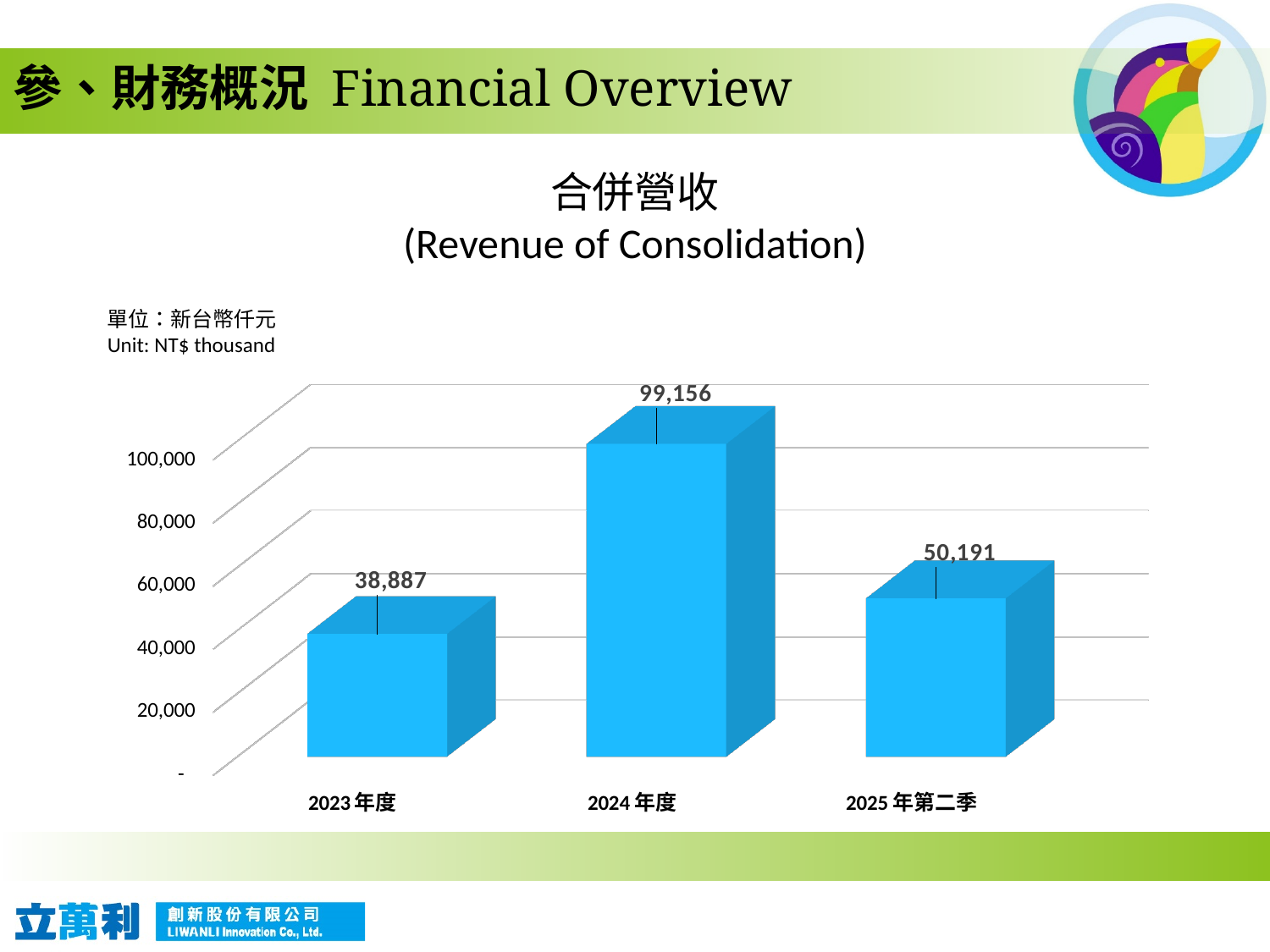
What is the consolidated revenue for 2025 年第二季? 50,191 What is the consolidated revenue for 2024 年度? 99,156 What unit is used for the values on the chart? NT$ thousand What is the difference in revenue between 2024 年度 and 2023 年度? 60,269 Which period has the lowest consolidated revenue? 2023 年度 Which is larger, the revenue for 2025 年第二季 or for 2023 年度? 2025 年第二季 Is the revenue for 2023 年度 greater or less than 40,000? less What is the consolidated revenue for 2023 年度? 38,887 What is the difference in revenue between 2025 年第二季 and 2023 年度? 11,304 How many periods are shown on the chart? 3 Which period has the highest consolidated revenue? 2024 年度 What kind of chart is shown on the slide? bar chart